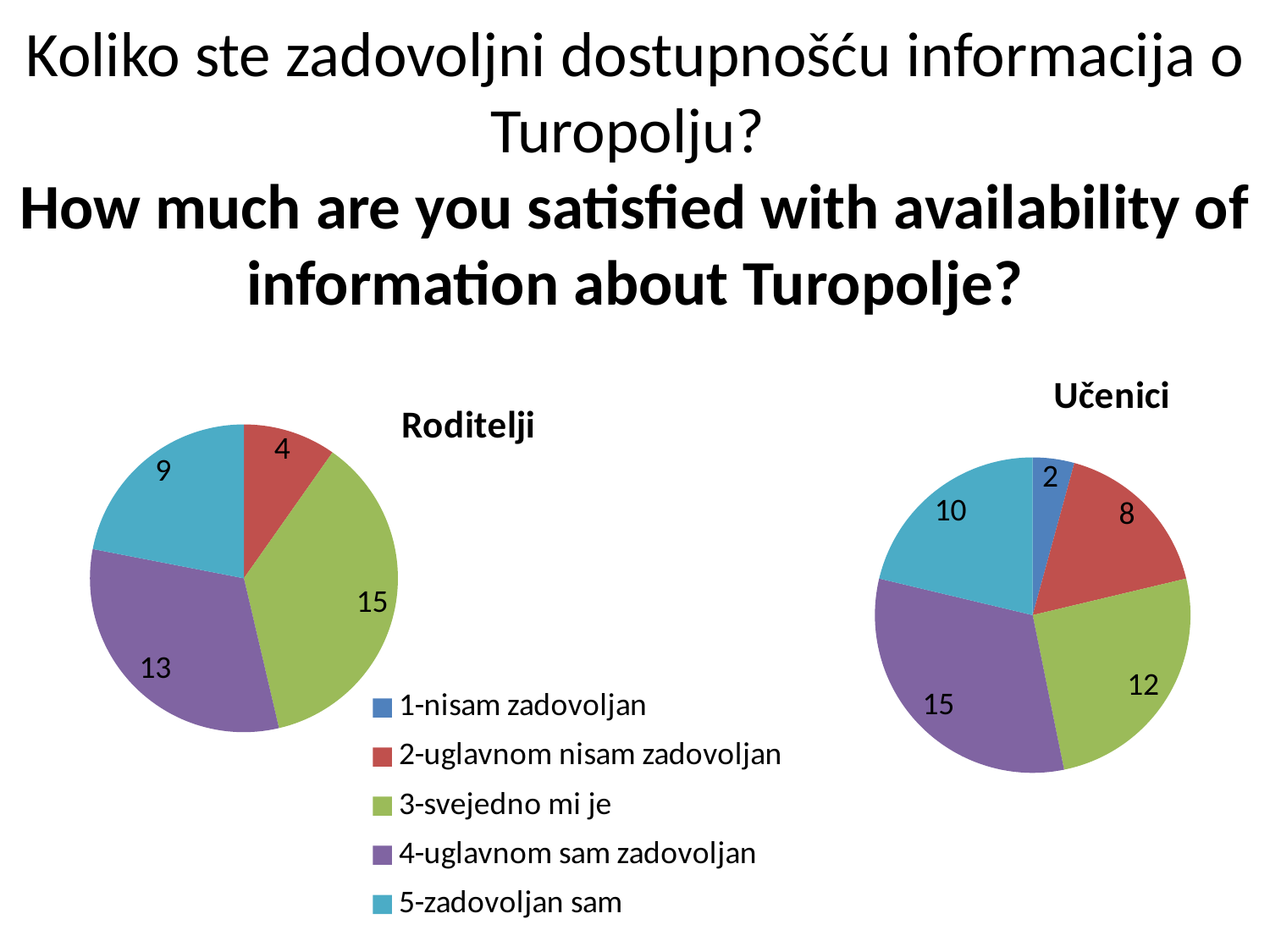
In the Učenici pie chart, which is larger: the value for 3-svejedno mi je or the value for 5-zadovoljan sam? 3-svejedno mi je How many slices are shown in the Učenici pie chart? 5 In the Roditelji pie chart, what is the difference between the values for 3-svejedno mi je and 4-uglavnom sam zadovoljan? 2 In the Učenici pie chart, what is the value for 2-uglavnom nisam zadovoljan? 8 In the Roditelji pie chart, what is the value for 3-svejedno mi je? 15 In the Učenici pie chart, which category has the largest slice? 4-uglavnom sam zadovoljan How many entries does the legend list? 5 In the Učenici pie chart, what is the value for 1-nisam zadovoljan? 2 In the Učenici pie chart, which category has the smallest slice? 1-nisam zadovoljan In the Roditelji pie chart, what is the value for 5-zadovoljan sam? 9 In the Roditelji pie chart, which category has the smallest slice? 2-uglavnom nisam zadovoljan What type of chart is the Roditelji chart? Pie chart